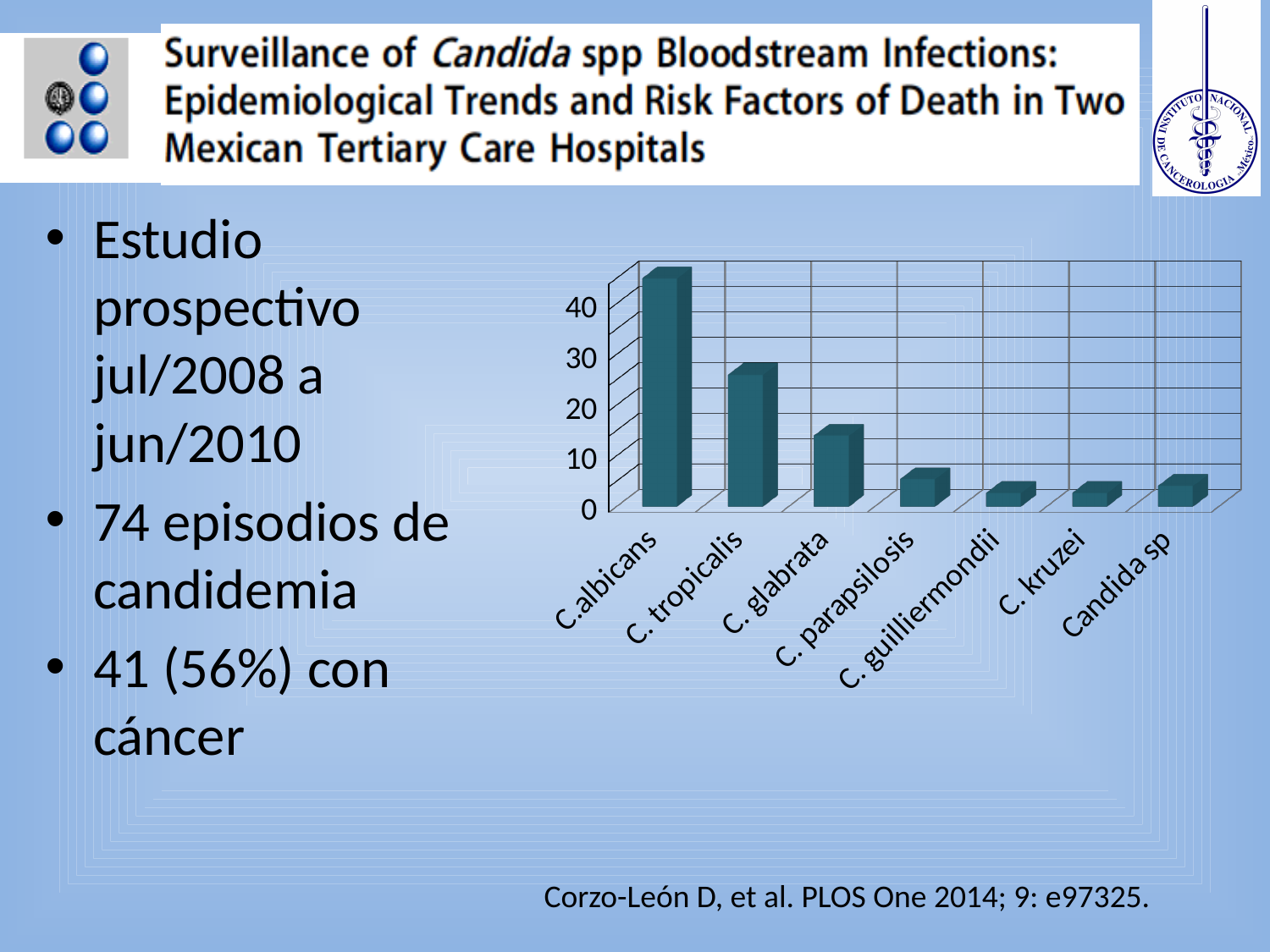
How many Candida categories are plotted on the x axis of the chart? 7 What is the label of the last category on the x axis of the chart? Candida sp Which is larger, the value for C. tropicalis or the value for C. glabrata? C. tropicalis What kind of chart is shown on the slide? bar chart Is the value for C. tropicalis greater or less than 20? greater Is the value for C. tropicalis greater or less than 30? less Which category has the highest bar in the chart? C.albicans Is the value for C.albicans greater or less than 40? greater Which is larger, the value for C.albicans or the value for C. tropicalis? C.albicans What is the highest tick value shown on the vertical axis of the chart? 40